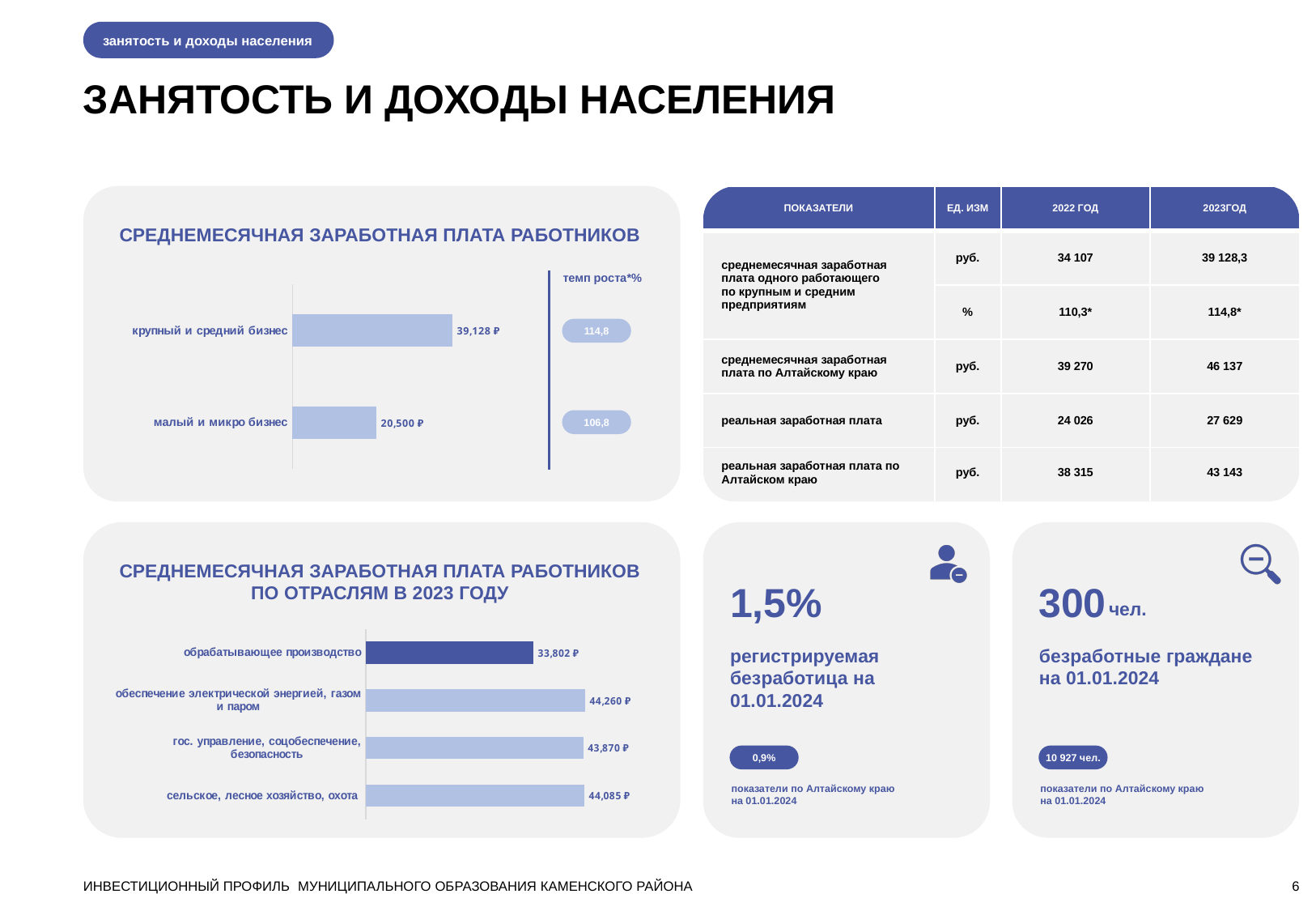
In the chart 'СРЕДНЕМЕСЯЧНАЯ ЗАРАБОТНАЯ ПЛАТА РАБОТНИКОВ ПО ОТРАСЛЯМ В 2023 ГОДУ' (bottom left), which category has the lowest value? обрабатывающее производство What kind of chart is 'СРЕДНЕМЕСЯЧНАЯ ЗАРАБОТНАЯ ПЛАТА РАБОТНИКОВ ПО ОТРАСЛЯМ В 2023 ГОДУ' (bottom left)? bar chart In the chart 'СРЕДНЕМЕСЯЧНАЯ ЗАРАБОТНАЯ ПЛАТА РАБОТНИКОВ' (top left), what is the difference between the values for 'крупный и средний бизнес' and 'малый и микро бизнес'? 18,628 ₽ In the chart 'СРЕДНЕМЕСЯЧНАЯ ЗАРАБОТНАЯ ПЛАТА РАБОТНИКОВ' (top left), what is the 'темп роста' value shown for 'малый и микро бизнес'? 106,8 How many categories are shown in the chart 'СРЕДНЕМЕСЯЧНАЯ ЗАРАБОТНАЯ ПЛАТА РАБОТНИКОВ' (top left)? 2 In the chart 'СРЕДНЕМЕСЯЧНАЯ ЗАРАБОТНАЯ ПЛАТА РАБОТНИКОВ ПО ОТРАСЛЯМ В 2023 ГОДУ' (bottom left), what is the value for 'сельское, лесное хозяйство, охота'? 44,085 ₽ In the chart 'СРЕДНЕМЕСЯЧНАЯ ЗАРАБОТНАЯ ПЛАТА РАБОТНИКОВ' (top left), what is the value for 'малый и микро бизнес'? 20,500 ₽ In the chart 'СРЕДНЕМЕСЯЧНАЯ ЗАРАБОТНАЯ ПЛАТА РАБОТНИКОВ ПО ОТРАСЛЯМ В 2023 ГОДУ' (bottom left), what is the difference between the values for 'обеспечение электрической энергией, газом и паром' and 'обрабатывающее производство'? 10,458 ₽ How many categories are shown in the chart 'СРЕДНЕМЕСЯЧНАЯ ЗАРАБОТНАЯ ПЛАТА РАБОТНИКОВ ПО ОТРАСЛЯМ В 2023 ГОДУ' (bottom left)? 4 In the chart 'СРЕДНЕМЕСЯЧНАЯ ЗАРАБОТНАЯ ПЛАТА РАБОТНИКОВ ПО ОТРАСЛЯМ В 2023 ГОДУ' (bottom left), which category has the highest value? обеспечение электрической энергией, газом и паром In the chart 'СРЕДНЕМЕСЯЧНАЯ ЗАРАБОТНАЯ ПЛАТА РАБОТНИКОВ' (top left), what is the value for 'крупный и средний бизнес'? 39,128 ₽ In the chart 'СРЕДНЕМЕСЯЧНАЯ ЗАРАБОТНАЯ ПЛАТА РАБОТНИКОВ ПО ОТРАСЛЯМ В 2023 ГОДУ' (bottom left), what is the value for 'обрабатывающее производство'? 33,802 ₽